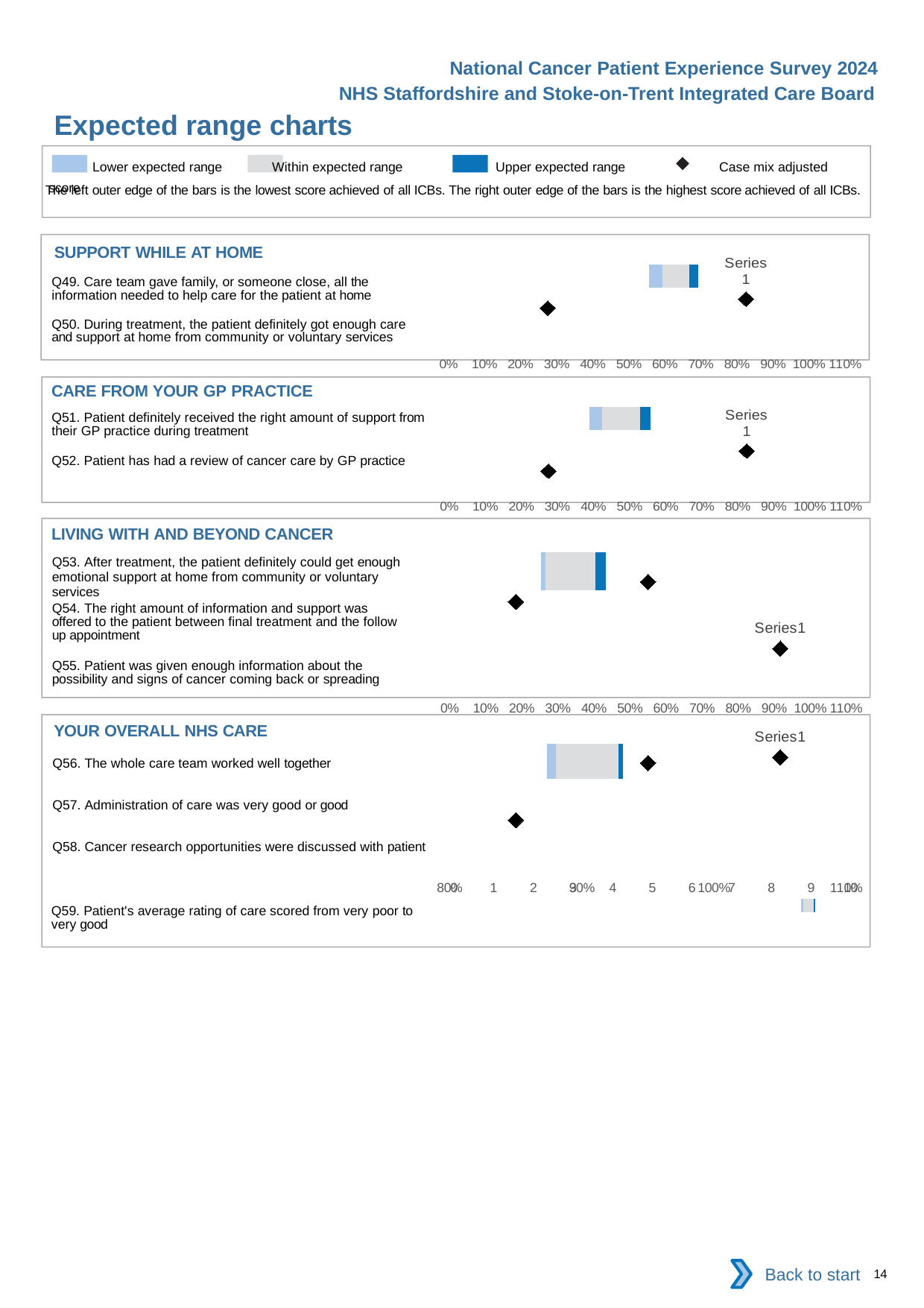
What is the highest percentage tick shown on the x axis of the "LIVING WITH AND BEYOND CANCER" chart? 110% What kind of chart is used in the "SUPPORT WHILE AT HOME" section? bar chart How many questions are listed in the "LIVING WITH AND BEYOND CANCER" chart? 3 How many questions are listed in the "YOUR OVERALL NHS CARE" chart? 4 In the "CARE FROM YOUR GP PRACTICE" chart, is the right edge of the expected range bar for Q51 greater or less than 70%? less How many questions are listed in the "CARE FROM YOUR GP PRACTICE" chart? 2 In the "SUPPORT WHILE AT HOME" chart, is the left edge of the expected range bar for Q49 greater or less than 50%? greater According to the legend, what does the diamond marker represent? Case mix adjusted score How many entries does the legend at the top of the slide list? 4